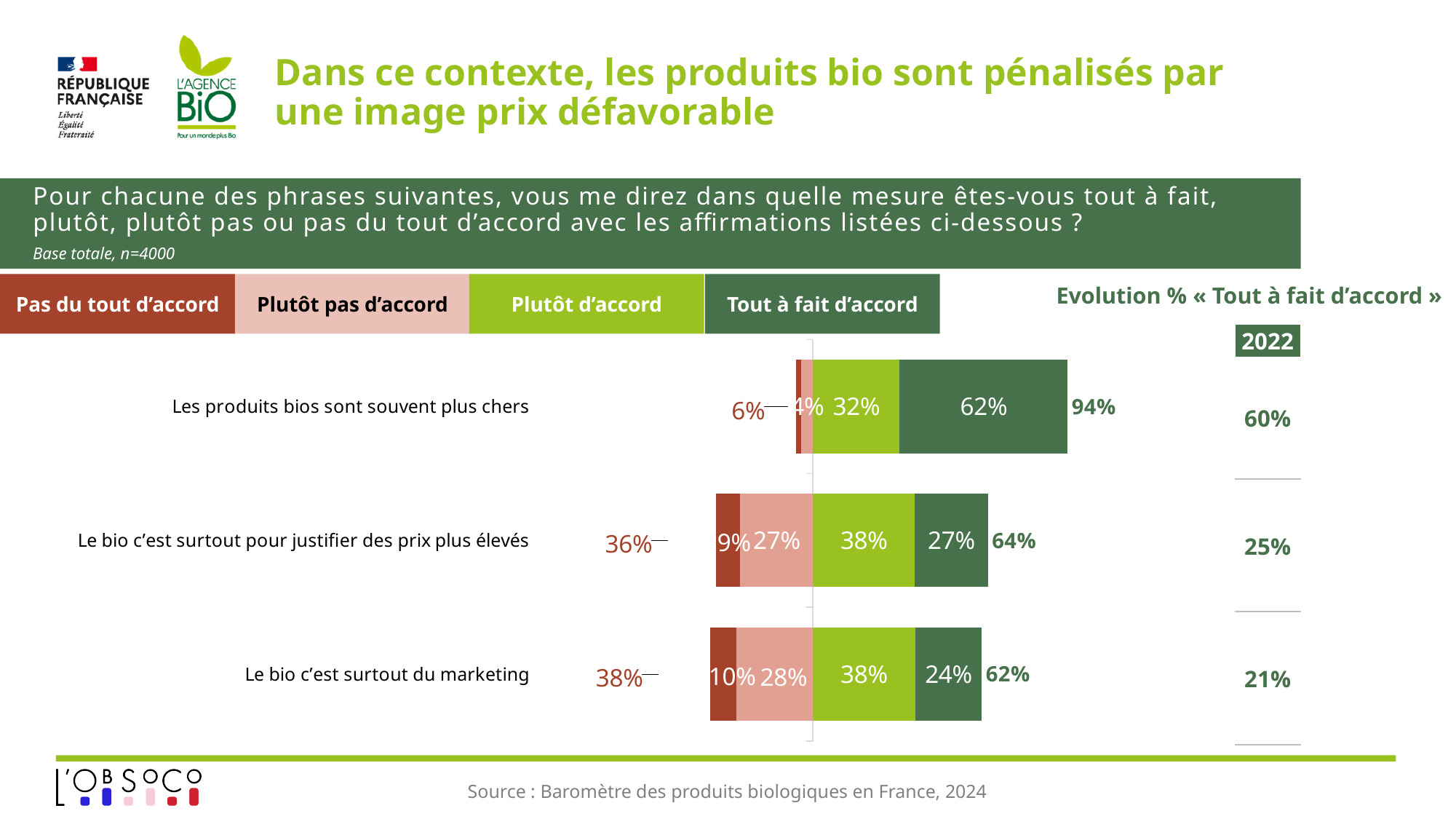
What is the difference between the 'Tout à fait d'accord' share for 'Les produits bios sont souvent plus chers' in 2024 (62%) and in 2022 (60%)? 2 points What type of chart is shown on the slide? Stacked bar chart What is the 'Pas du tout d'accord' share for 'Le bio c'est surtout pour justifier des prix plus élevés'? 9% What percentage of respondents are 'Tout à fait d'accord' that 'Les produits bios sont souvent plus chers'? 62% Which statement has the highest 'Tout à fait d'accord' share? Les produits bios sont souvent plus chers Which is larger: the 'Plutôt pas d'accord' share for 'Le bio c'est surtout du marketing' or for 'Le bio c'est surtout pour justifier des prix plus élevés'? Le bio c'est surtout du marketing How many statements are shown in the chart? 3 What is the combined agreement total (Plutôt d'accord + Tout à fait d'accord) for 'Le bio c'est surtout pour justifier des prix plus élevés'? 64% What percentage of respondents are 'Plutôt pas d'accord' with 'Le bio c'est surtout du marketing'? 28% Which statement has the lowest combined agreement (Plutôt d'accord + Tout à fait d'accord) total? Le bio c'est surtout du marketing What was the 2022 'Tout à fait d'accord' percentage for 'Le bio c'est surtout du marketing'? 21% How many response categories does the legend list? 4